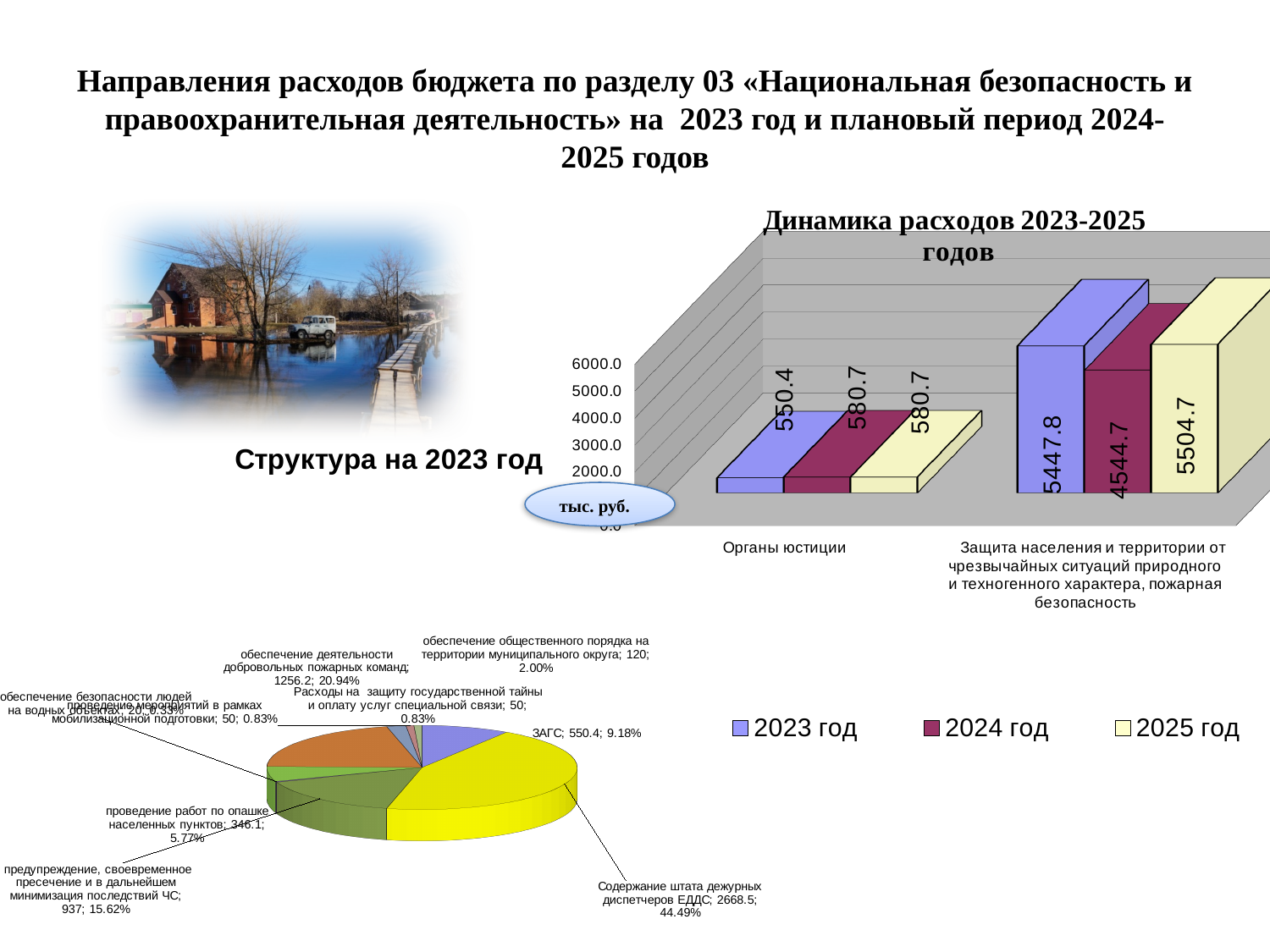
In the bar chart "Динамика расходов 2023-2025 годов", what is the value for Органы юстиции in 2023 год? 550.4 In the bar chart "Динамика расходов 2023-2025 годов", how many series does the legend list? 3 In the bar chart "Динамика расходов 2023-2025 годов", what is the value for Защита населения и территории от чрезвычайных ситуаций in 2024 год? 4544.7 In the pie chart "Структура на 2023 год", what is the value for предупреждение, своевременное пресечение и в дальнейшем минимизация последствий ЧС? 937 In the bar chart "Динамика расходов 2023-2025 годов", which is larger for 2023 год: Органы юстиции or Защита населения и территории от чрезвычайных ситуаций? Защита населения и территории от чрезвычайных ситуаций In the bar chart "Динамика расходов 2023-2025 годов", what is the difference between the 2025 год and 2023 год values for Органы юстиции? 30.3 In the pie chart "Структура на 2023 год", what share does обеспечение деятельности добровольных пожарных команд have? 20.94% In the bar chart "Динамика расходов 2023-2025 годов", which year has the highest value for Защита населения и территории от чрезвычайных ситуаций? 2025 год In the pie chart "Структура на 2023 год", what is the value for Содержание штата дежурных диспетчеров ЕДДС? 2668.5 In the pie chart "Структура на 2023 год", which slice is the largest? Содержание штата дежурных диспетчеров ЕДДС What kind of chart is "Динамика расходов 2023-2025 годов"? Bar chart In the pie chart "Структура на 2023 год", what share does ЗАГС have? 9.18%